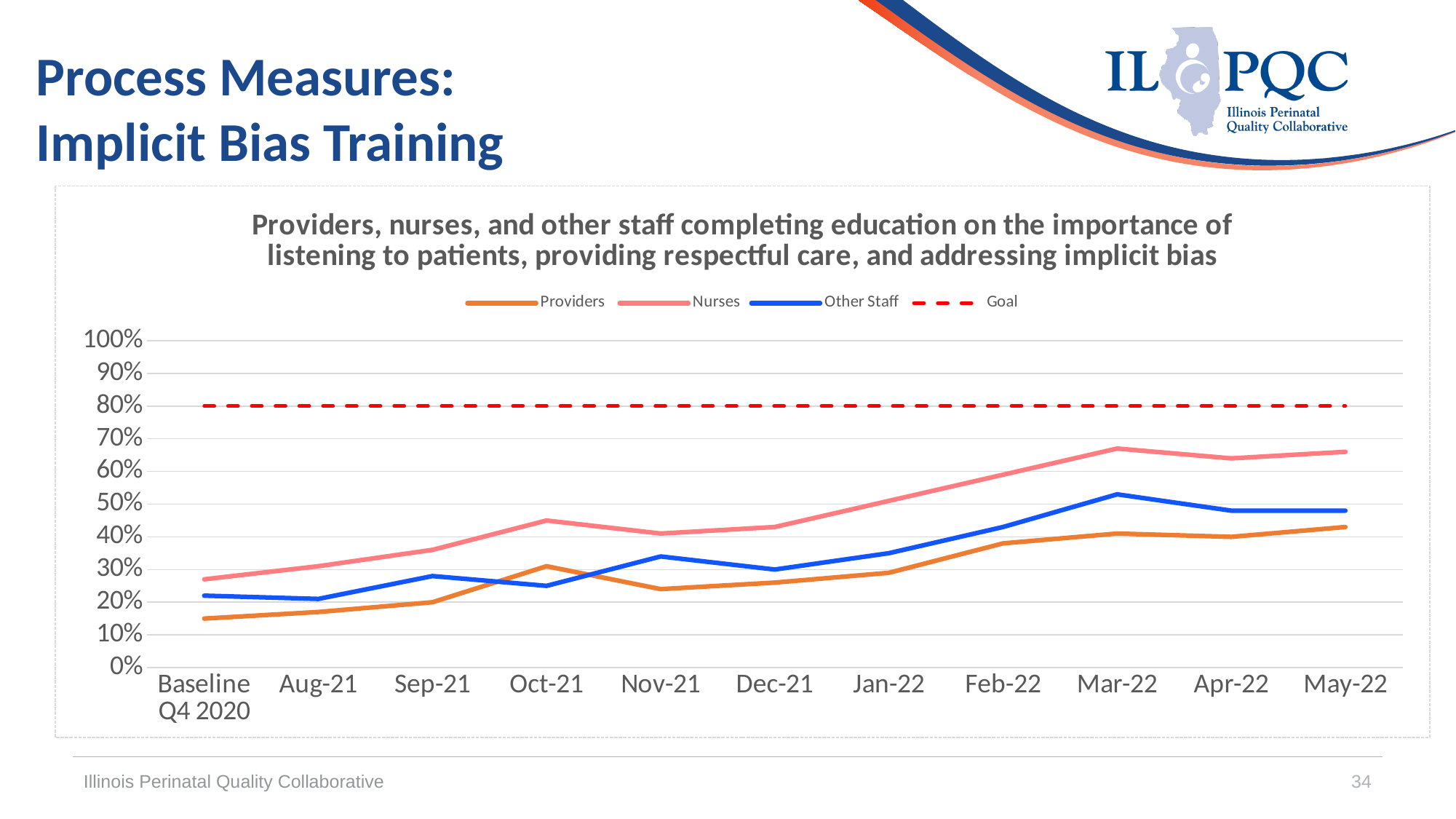
What value does the Goal line sit at? 80% Is the value for Providers in Nov-21 greater or less than 30%? less Is the value for Nurses in Mar-22 greater or less than 60%? greater Is the value for Nurses at Baseline Q4 2020 greater or less than 30%? less Which series has the higher value in Oct-21, Providers or Other Staff? Providers How many time points are shown on the x axis? 11 In which month does the Other Staff line reach its highest value? Mar-22 What type of chart is shown on the slide? Line chart At which time point is the Providers line at its lowest? Baseline Q4 2020 How many series does the legend list? 4 Does the Nurses line generally rise or fall from Baseline Q4 2020 to May-22? Rise